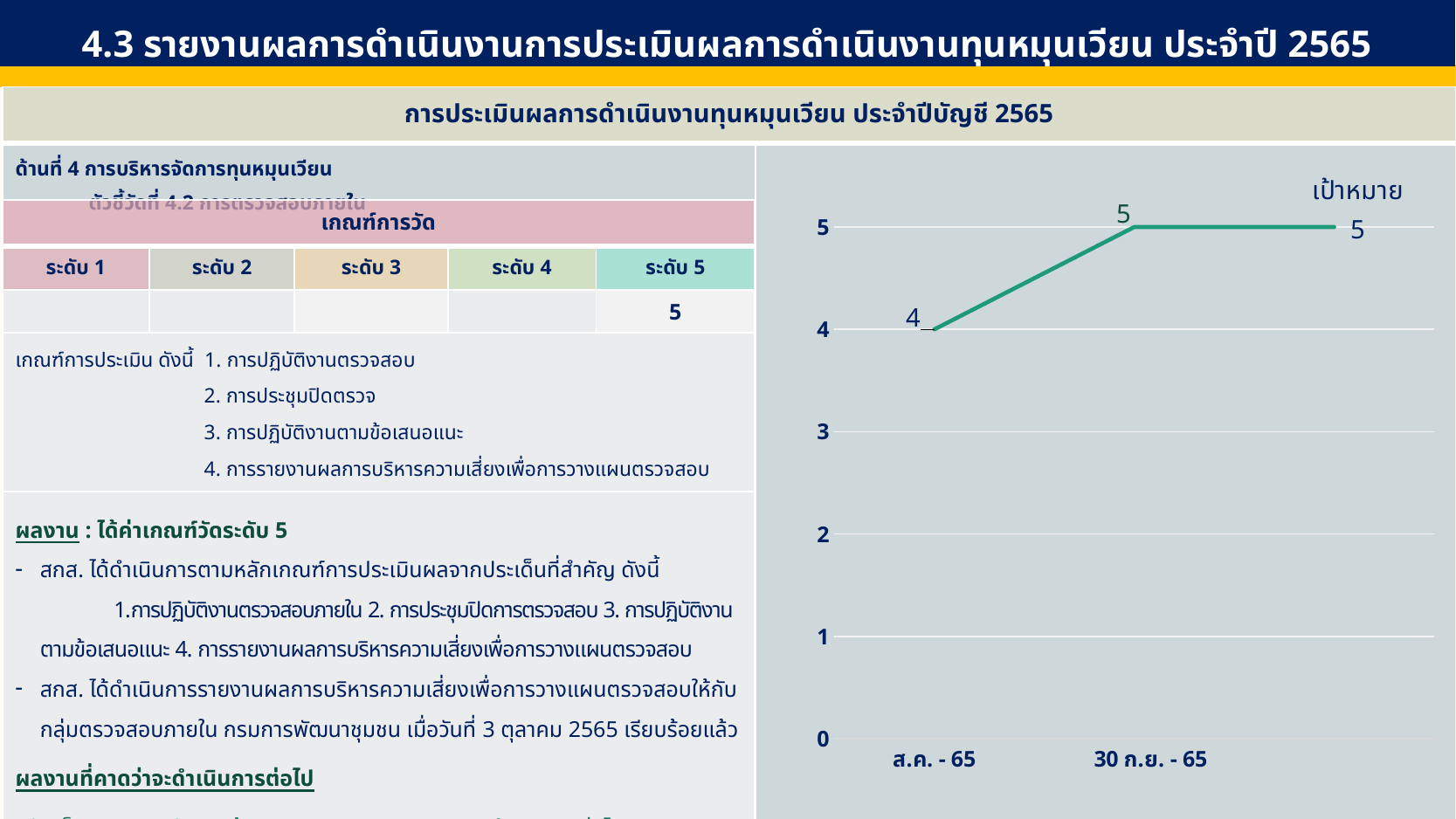
How many x-axis categories are labelled on the chart? 2 What is the value plotted for 30 ก.ย. - 65? 5 What is the difference between the value for 30 ก.ย. - 65 and the value for ส.ค. - 65? 1 What is the maximum value shown on the chart's y axis? 5 What kind of chart is shown on the right side of the slide? line chart Do the plotted values rise or fall from ส.ค. - 65 to 30 ก.ย. - 65? rise What is the value plotted for ส.ค. - 65? 4 Which x-axis category has the lowest plotted value? ส.ค. - 65 Which x-axis category has the highest plotted value? 30 ก.ย. - 65 What colour is the line plotted on the chart? green What is the value shown for เป้าหมาย (target) on the chart? 5 Which is larger, the value for ส.ค. - 65 or the value for 30 ก.ย. - 65? 30 ก.ย. - 65